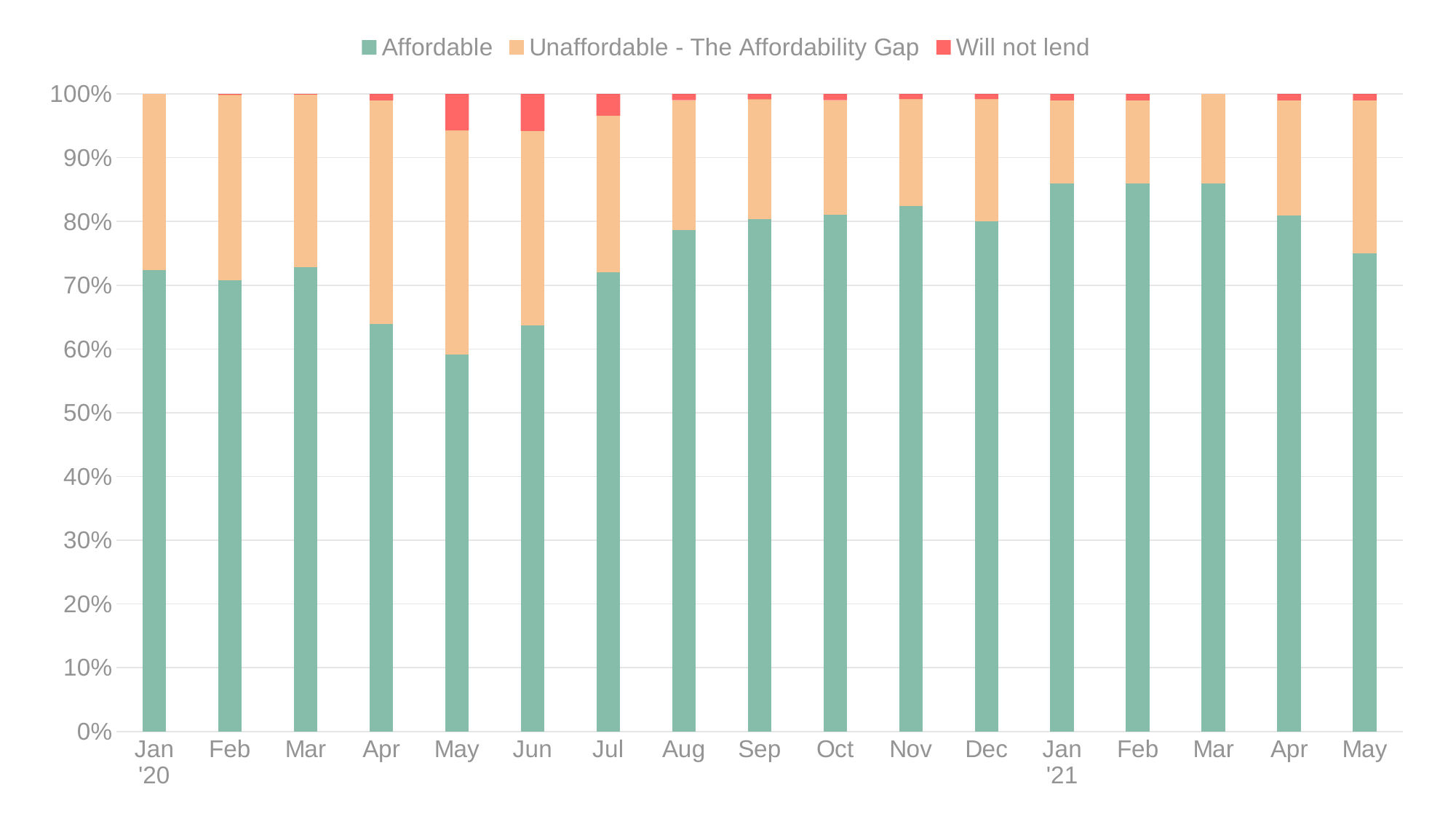
Is the Affordable value for May '20 greater or less than 70%? less Is the Affordable value for Apr '20 greater or less than 70%? less What kind of chart is shown on the slide? Stacked bar chart Is the Affordable value for Jan '21 greater or less than 80%? greater How many months are plotted along the x axis? 17 What is the total of the stacked bar for Jan '20? 100% Which series is shown in red in the legend? Will not lend Which has the larger Affordable share, Jan '20 or May '20? Jan '20 Which month has the lowest Affordable share? May '20 Which has the larger Affordable share, Jun '20 or Nov '20? Nov '20 How many series does the legend list? 3